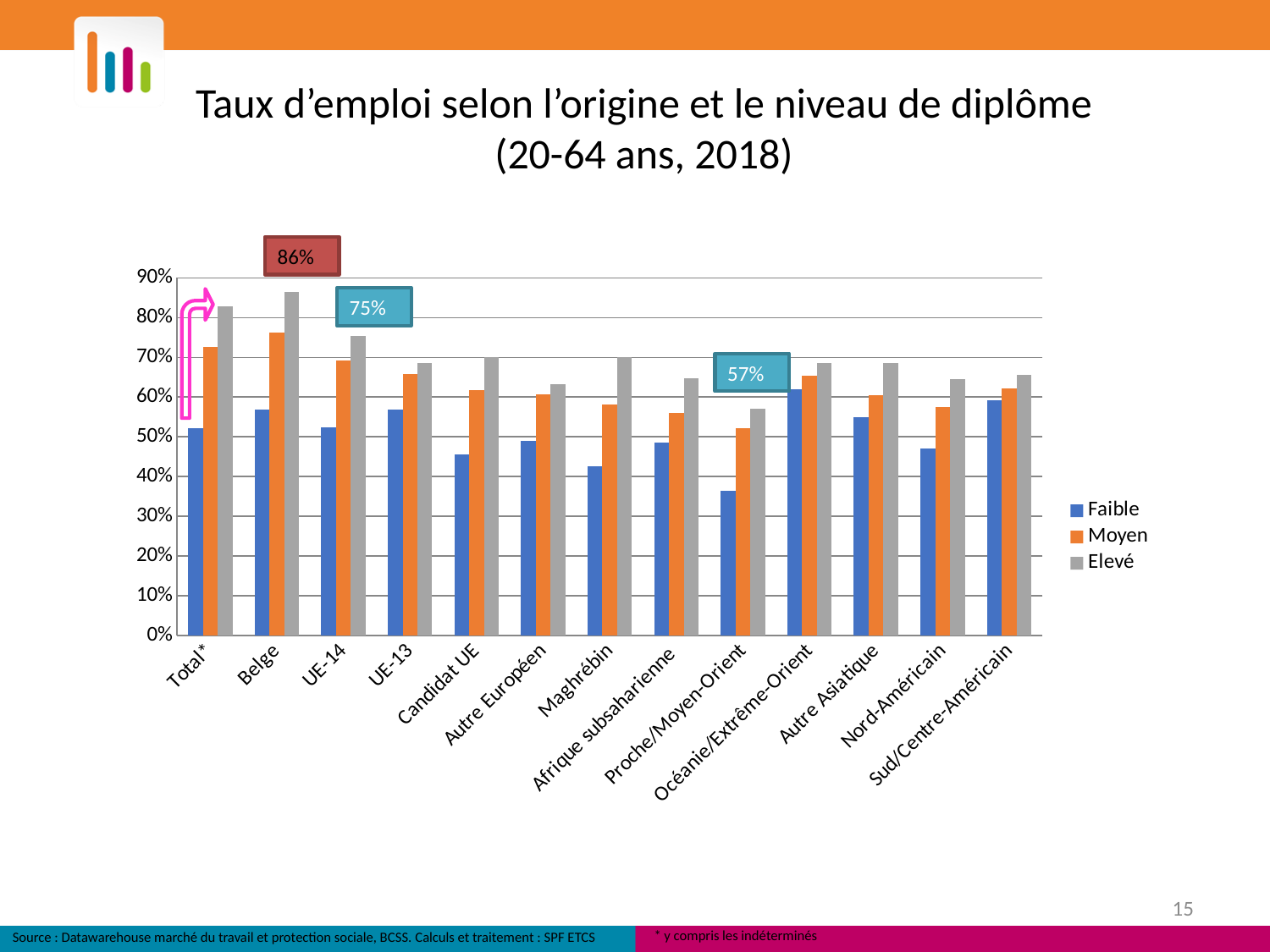
How many series does the legend list? 3 Which origin category has the highest value for the Elevé series? Belge What value is annotated for the Elevé bar of the Proche/Moyen-Orient category? 57% Which origin category has the lowest value for the Faible series? Proche/Moyen-Orient Is the Faible value for Candidat UE greater or less than 50%? less How many origin categories are shown on the x axis? 13 Is the Moyen value for Belge greater or less than 70%? greater What are the three series listed in the legend? Faible, Moyen, Elevé What kind of chart is shown on the slide? bar chart Which is larger, the Moyen value for Belge or the Moyen value for UE-14? Belge What value is annotated for the Elevé bar of the Belge category? 86% Is the Faible value for Proche/Moyen-Orient greater or less than 40%? less